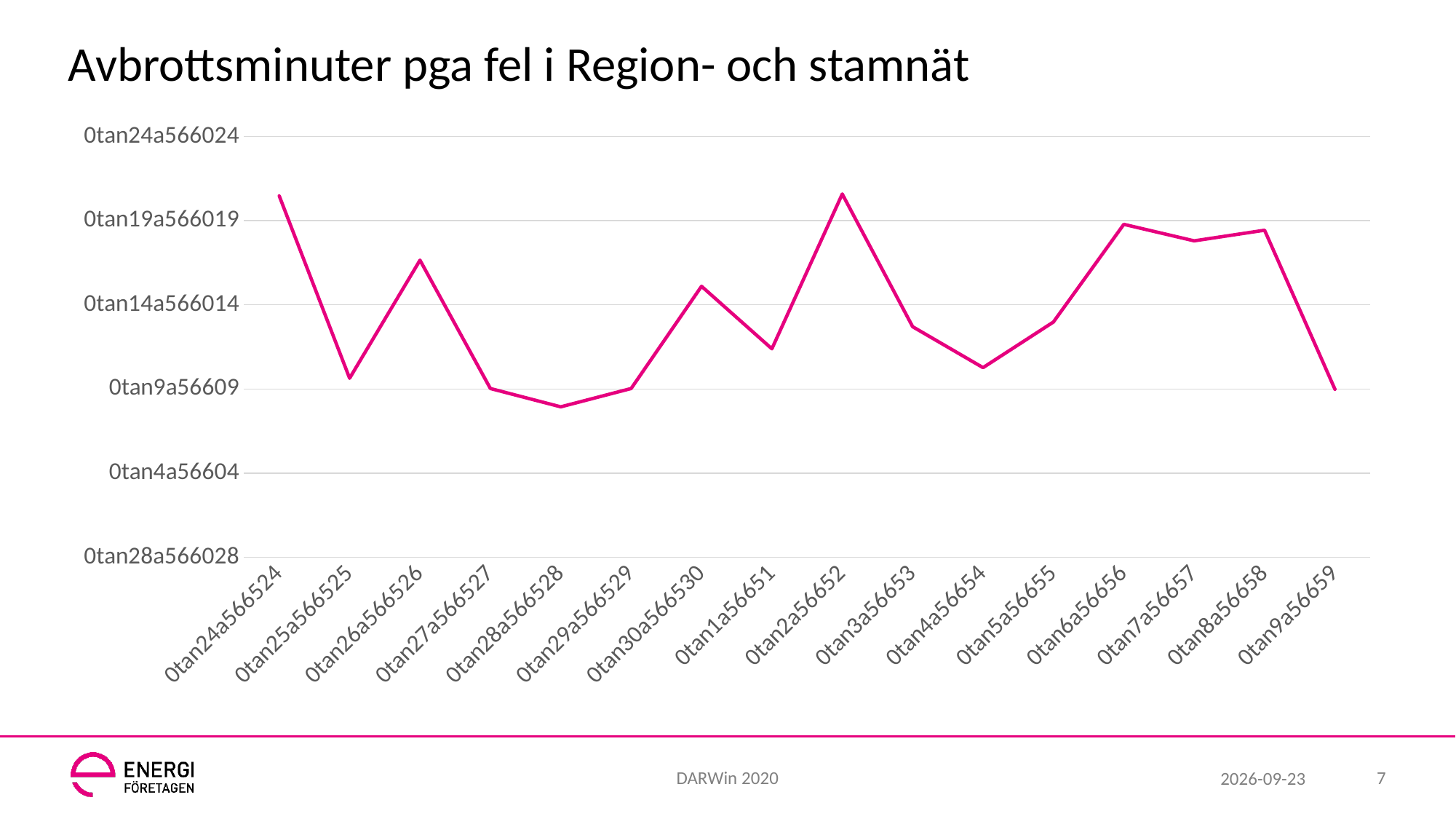
Is the value at 0tan4a56654 above or below the gridline labelled 0tan14a566014? below How many points are plotted along the x axis? 16 Does the line rise or fall from 0tan4a56654 to 0tan6a56656? rise Which is larger, the value at 0tan8a56658 or the value at 0tan9a56659? 0tan8a56658 Does the line rise or fall from 0tan24a566524 to 0tan25a566525? fall Is the value at 0tan26a566526 above or below the gridline labelled 0tan14a566014? above Which x-axis category has the lowest value on the line? 0tan28a566528 What is the title of the chart? Avbrottsminuter pga fel i Region- och stamnät Which is larger, the value at 0tan2a56652 or the value at 0tan3a56653? 0tan2a56652 What kind of chart is shown on the slide? line chart Which is larger, the value at 0tan25a566525 or the value at 0tan26a566526? 0tan26a566526 What colour is the plotted line? pink